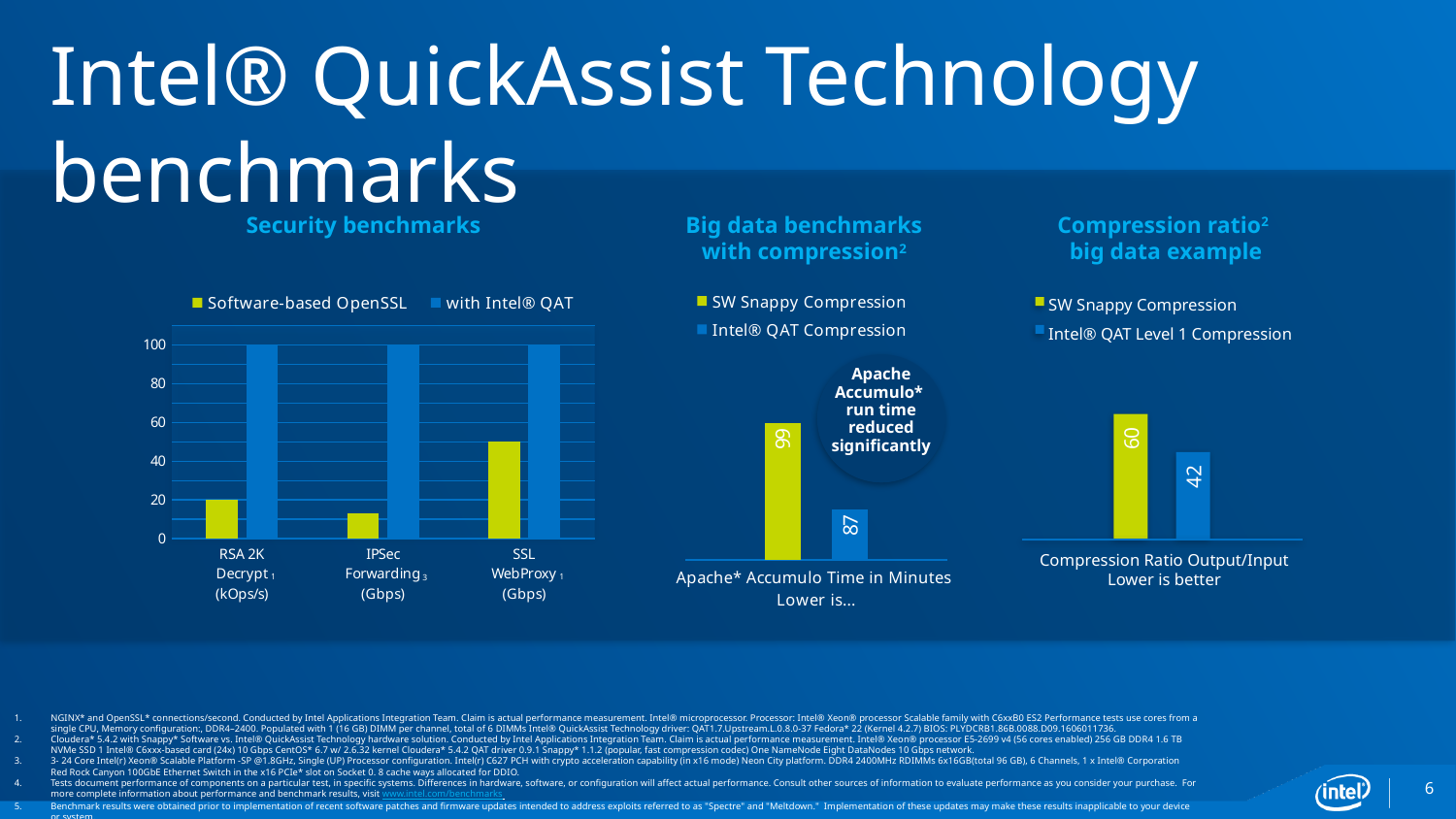
In the Big data benchmarks with compression chart, what is the difference between the SW Snappy Compression and Intel® QAT Compression values? 12 In the Security benchmarks chart, how many categories are shown on the x axis? 3 In the Security benchmarks chart, is the Software-based OpenSSL value for IPSec Forwarding greater or less than 20? less In the Security benchmarks chart, how many series does the legend list? 2 What kind of chart is the Security benchmarks chart? bar chart In the Security benchmarks chart, is the Software-based OpenSSL value for SSL WebProxy greater or less than 40? greater In the Security benchmarks chart, which category has the lowest Software-based OpenSSL value? IPSec Forwarding (Gbps) In the Compression ratio big data example chart, what is the value for Intel® QAT Level 1 Compression? 42 In the Big data benchmarks with compression chart, what is the value for SW Snappy Compression? 99 In the Security benchmarks chart, which series has the larger value for RSA 2K Decrypt, Software-based OpenSSL or with Intel® QAT? with Intel® QAT In the Big data benchmarks with compression chart, what is the value for Intel® QAT Compression? 87 In the Compression ratio big data example chart, which bar is higher, SW Snappy Compression or Intel® QAT Level 1 Compression? SW Snappy Compression